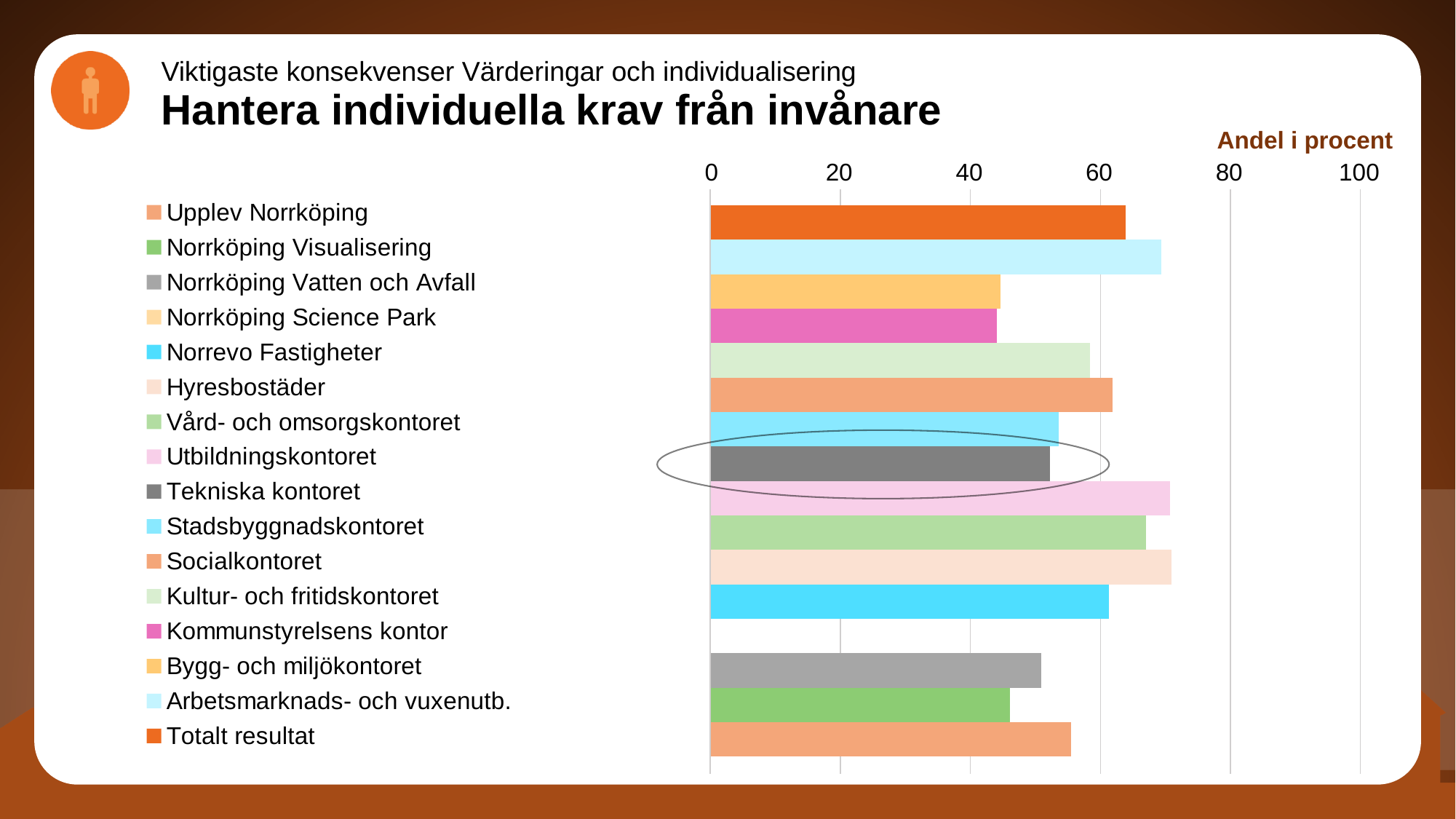
Is the value for Totalt resultat greater or less than 60? greater Is the value for Utbildningskontoret greater or less than 60? greater Which has the larger value, Vård- och omsorgskontoret or Norrköping Visualisering? Vård- och omsorgskontoret Which has the larger value, Arbetsmarknads- och vuxenutb. or Bygg- och miljökontoret? Arbetsmarknads- och vuxenutb. What kind of chart is shown on the slide? bar chart Is the value for Tekniska kontoret greater or less than 40? greater How many entries does the legend list? 16 Which legend entry's bar is circled on the chart? Tekniska kontoret What is the axis title shown above the horizontal axis? Andel i procent